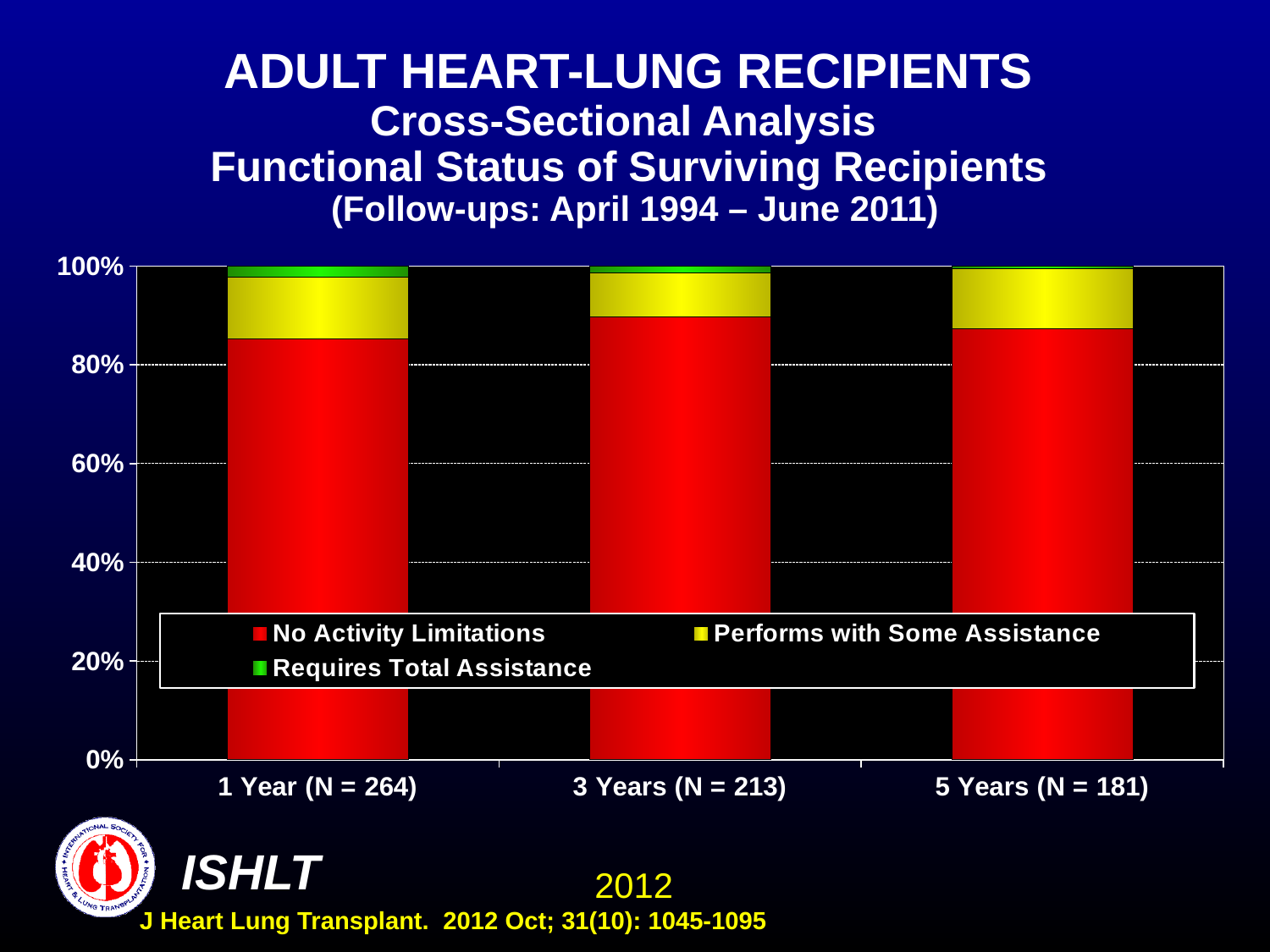
Which follow-up time point has the largest 'No Activity Limitations' share? 3 Years (N = 213) Is the 'No Activity Limitations' share larger at 1 Year (N = 264) or at 3 Years (N = 213)? 3 Years (N = 213) Which follow-up time point has the largest 'Requires Total Assistance' share? 1 Year (N = 264) What kind of chart is shown on the slide? Stacked bar chart Is the 'No Activity Limitations' value for 3 Years (N = 213) greater or less than 80%? greater Is the 'No Activity Limitations' value for 1 Year (N = 264) greater or less than 80%? greater Which colour represents 'Performs with Some Assistance' in the chart? Yellow Is the 'No Activity Limitations' value for 5 Years (N = 181) greater or less than 60%? greater What is the N value for the 5 Years category? 181 How many series does the legend list? 3 How many categories (follow-up time points) are shown on the x axis? 3